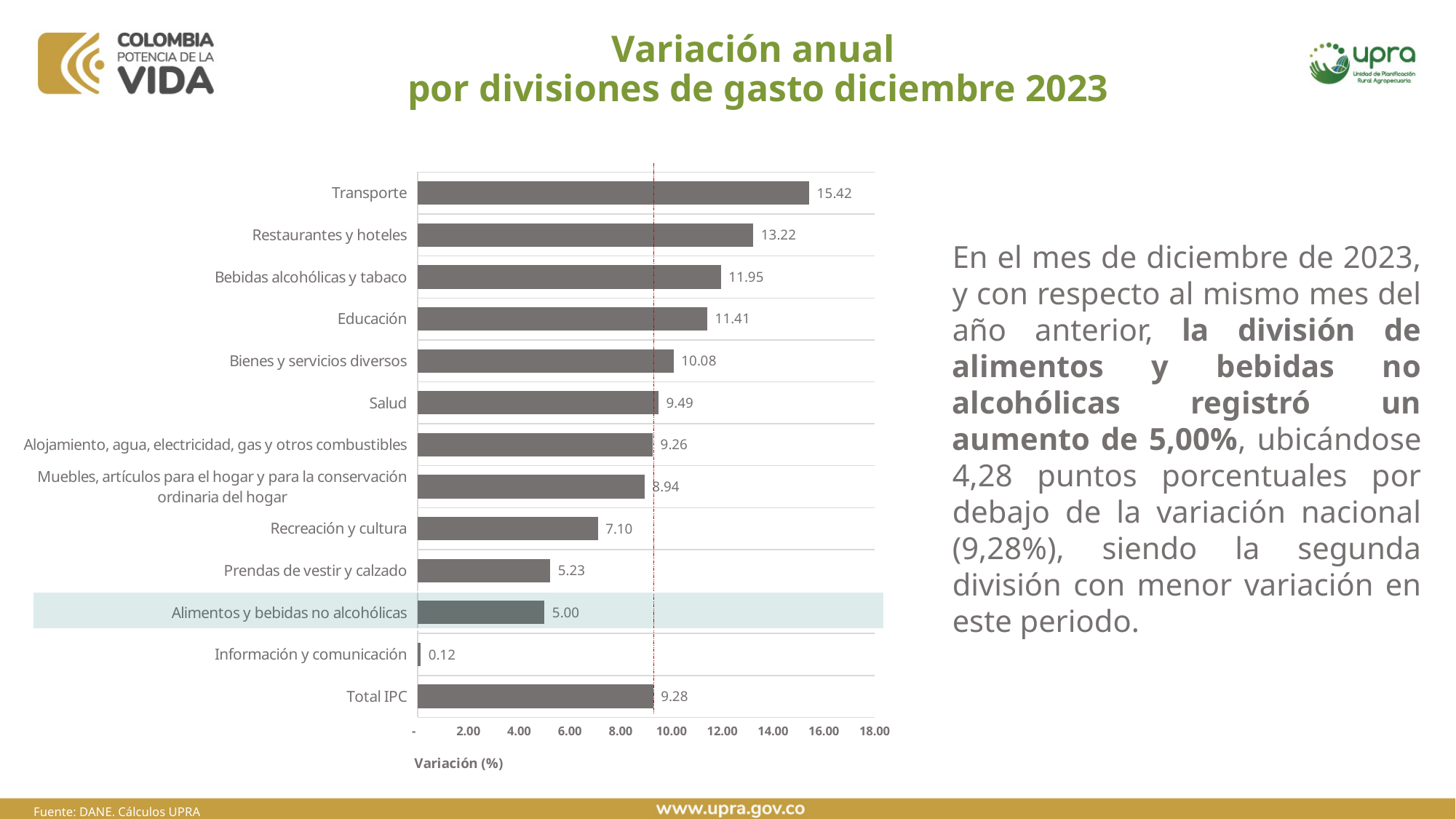
How many categories are shown on the chart? 13 What kind of chart is shown on the slide? bar chart What is the value for Alimentos y bebidas no alcohólicas? 5.00 What is the value for Recreación y cultura? 7.10 Which category has the highest value? Transporte What is the label of the x axis? Variación (%) What is the value for Transporte? 15.42 Which is larger, the value for Educación or the value for Bienes y servicios diversos? Educación Is the value for Prendas de vestir y calzado greater or less than 6.00? less What is the value for Total IPC? 9.28 Which category has the lowest value? Información y comunicación What is the difference between the values for Transporte and Restaurantes y hoteles? 2.20